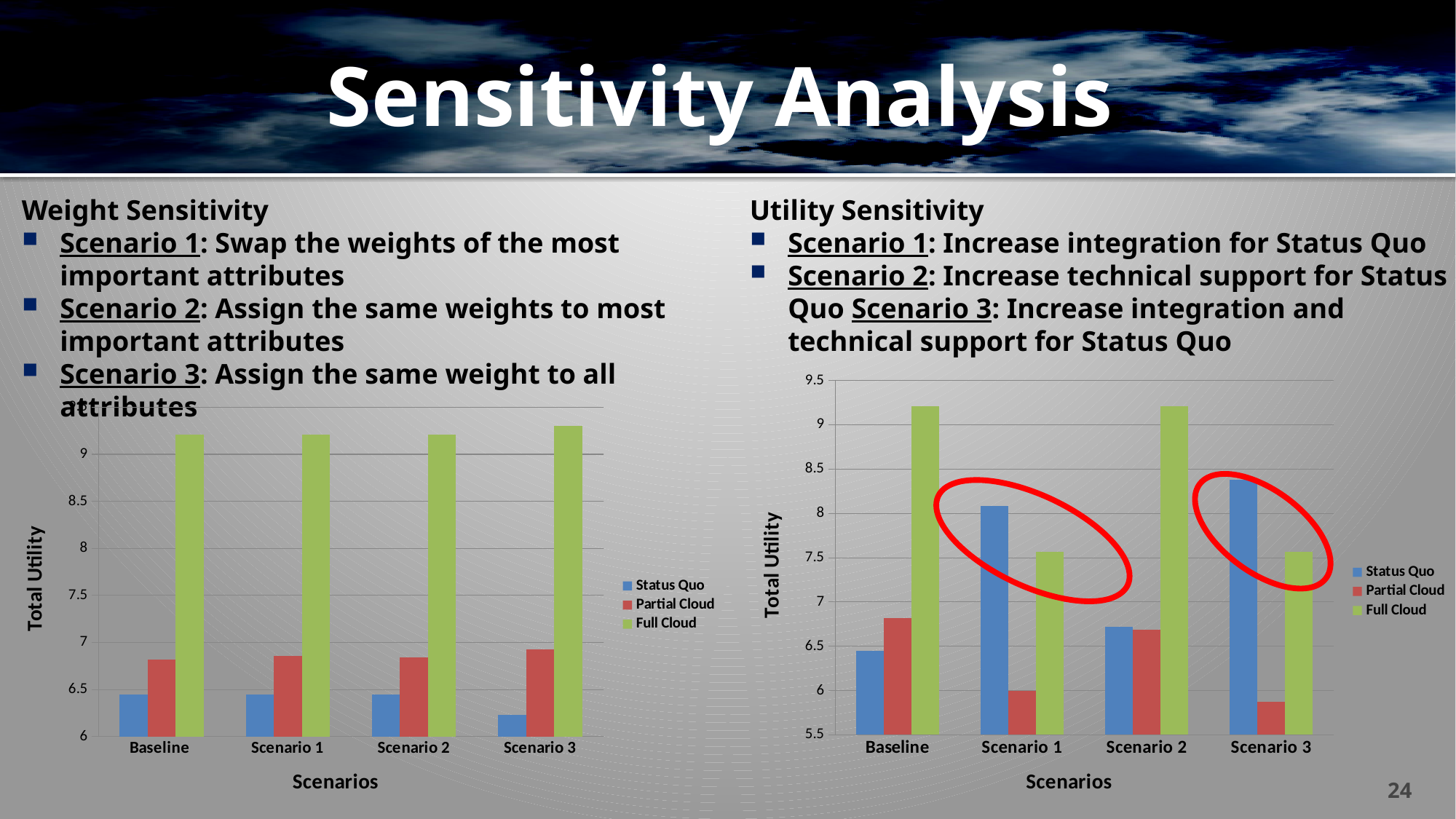
In the right chart (Utility Sensitivity), which series has the lowest value for Scenario 1? Partial Cloud In the left chart (Weight Sensitivity), which series has the highest value in every scenario? Full Cloud How many series does the legend of the left chart (Weight Sensitivity) list? 3 What is the y-axis title of the right chart (Utility Sensitivity)? Total Utility In the right chart (Utility Sensitivity), is the Status Quo value for Scenario 1 greater or less than 8? greater In the right chart (Utility Sensitivity), which series has the highest value for Scenario 3? Status Quo What kind of chart is the left chart (Weight Sensitivity)? bar chart How many scenario categories are shown on the x axis of the right chart (Utility Sensitivity)? 4 In the right chart (Utility Sensitivity), which is larger for Scenario 2: Status Quo or Full Cloud? Full Cloud In the left chart (Weight Sensitivity), is the Full Cloud value for Baseline greater or less than 9? greater In the left chart (Weight Sensitivity), is the Status Quo value for Scenario 3 greater or less than 6.5? less